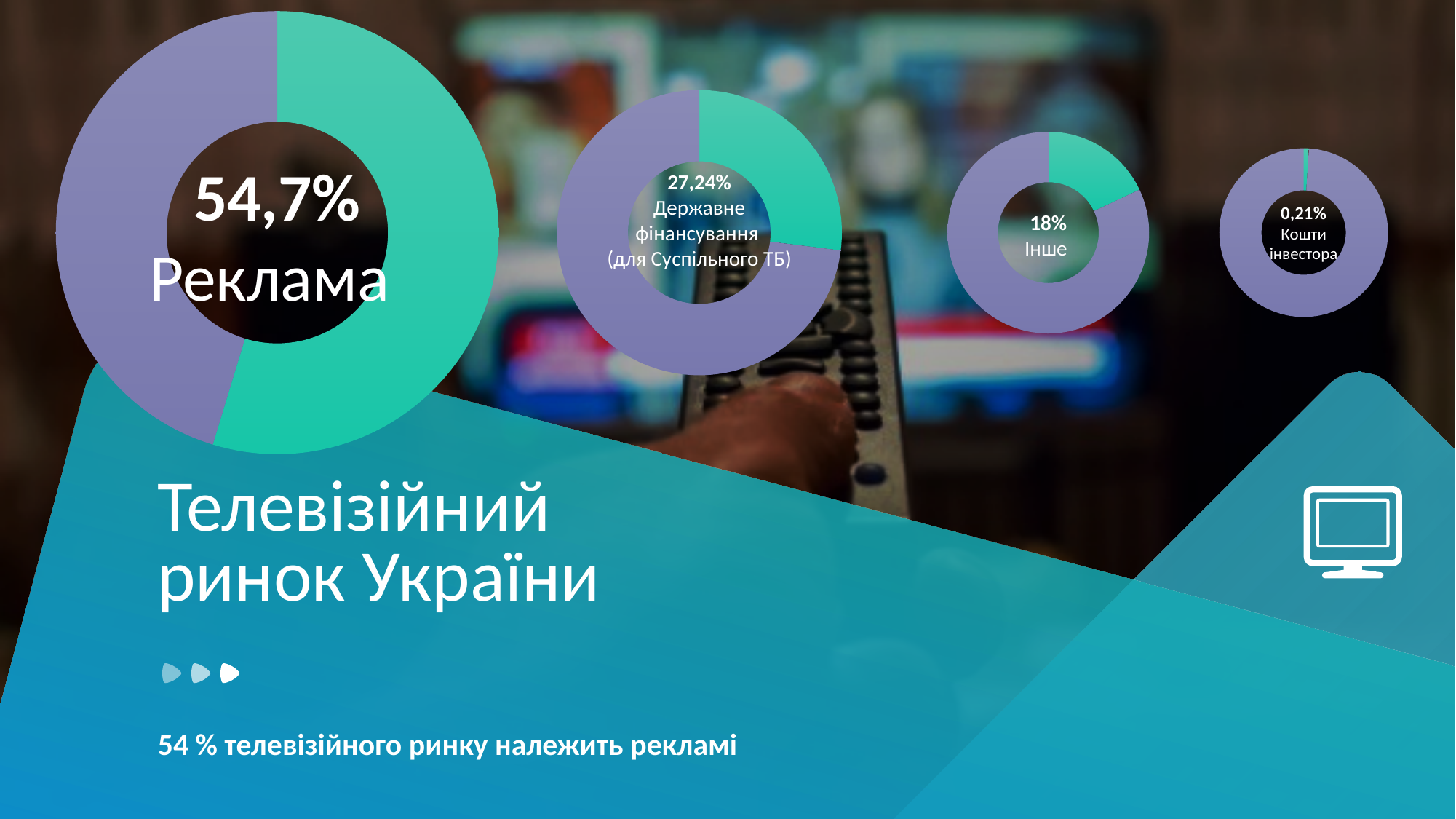
What is the title of the slide containing the donut charts? Телевізійний ринок України What percentage is shown in the donut chart labelled Інше? 18% What percentage is shown in the smallest donut chart, labelled Кошти інвестора? 0,21% How many donut charts are shown on the slide? 4 What share of the Ukrainian TV market does the largest donut chart attribute to Реклама? 54,7% What kind of chart is used to show the share of Реклама? Donut (pie) chart What is the difference in percentage points between the share for Інше and the share for Кошти інвестора? 17,79 Which of the four categories shown in the donut charts has the lowest share? Кошти інвестора Which of the four categories shown in the donut charts has the highest share? Реклама What percentage is shown in the donut chart labelled Державне фінансування (для Суспільного ТБ)? 27,24% Which is larger: the share for Державне фінансування (для Суспільного ТБ) or the share for Інше? Державне фінансування (для Суспільного ТБ) What is the difference in percentage points between the share for Реклама and the share for Державне фінансування (для Суспільного ТБ)? 27,46